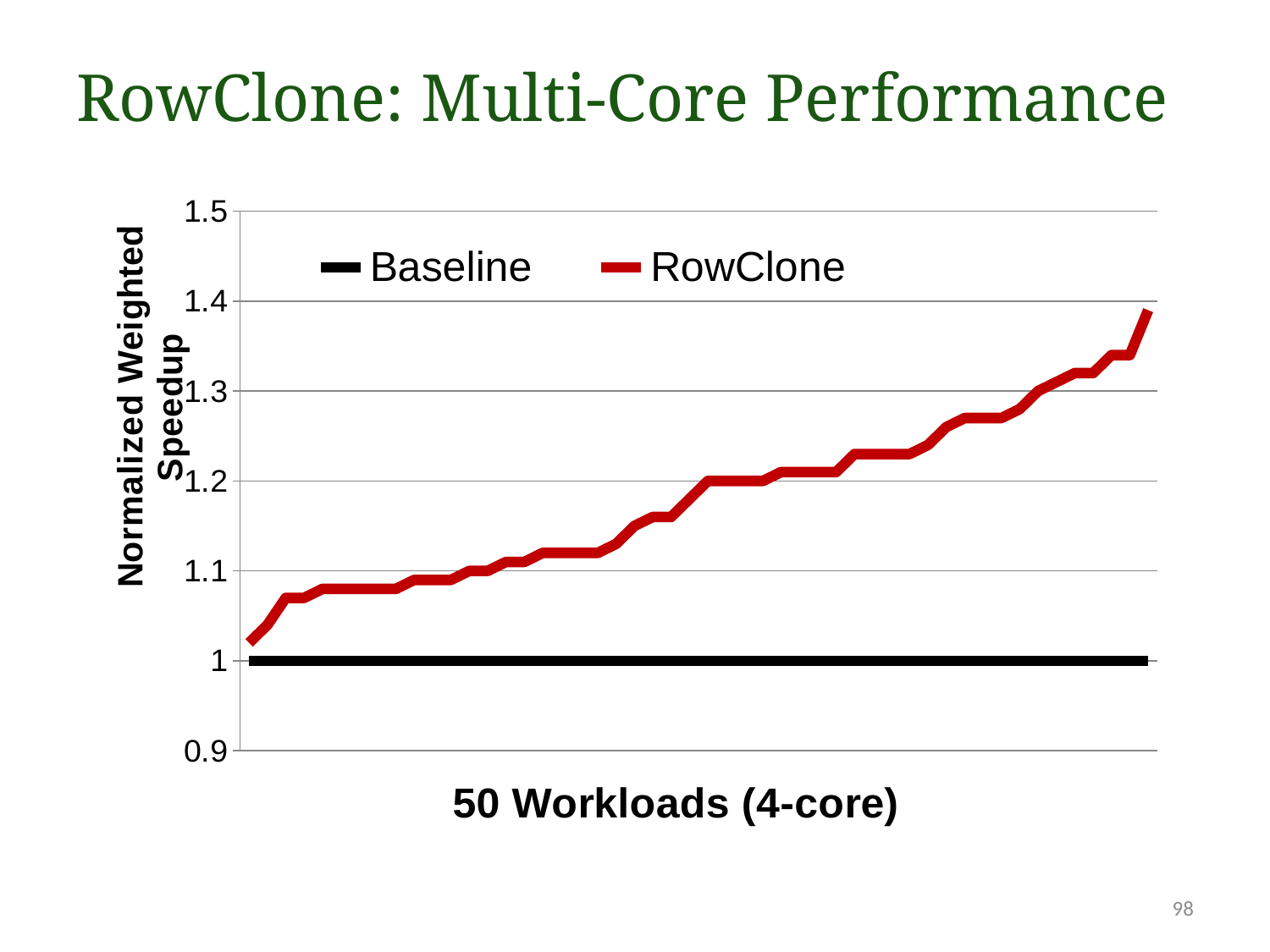
How many series does the legend list? 2 Is the highest RowClone value greater or less than 1.3? greater What kind of chart is shown on the slide? line chart Which two series are listed in the legend? Baseline and RowClone What is the value of the Baseline series across the workloads? 1 How many workloads does the x axis label say are plotted? 50 What is the y axis title of the chart? Normalized Weighted Speedup Is the highest RowClone value greater or less than 1.4? less Is the lowest RowClone value greater or less than 1.1? less Which series has higher values, RowClone or Baseline? RowClone What is the lowest value shown on the y axis? 0.9 Does the RowClone series rise or fall along the x axis? rise